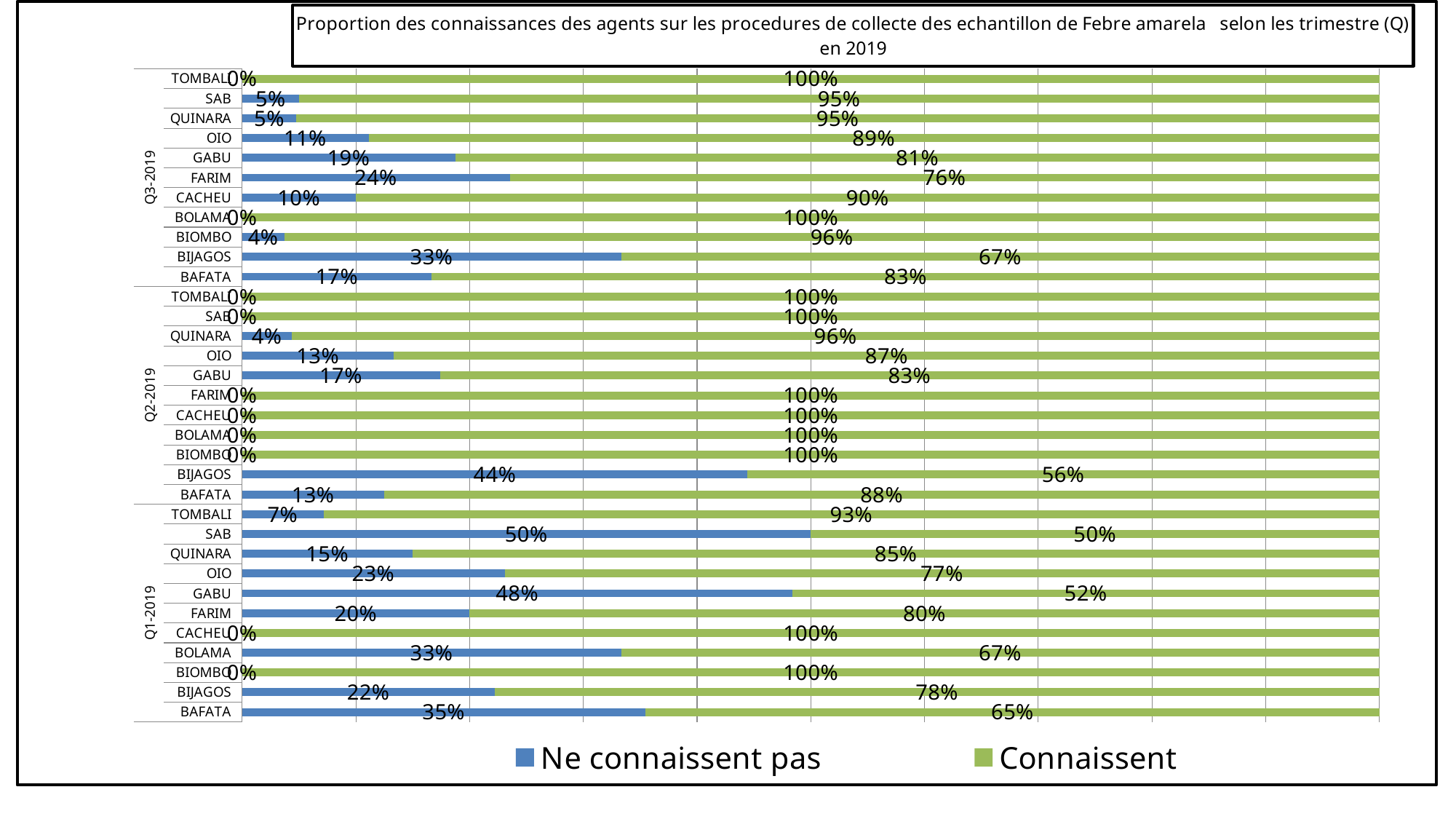
What is the 'Ne connaissent pas' value for BIJAGOS in Q2-2019? 44% What is the 'Ne connaissent pas' value for GABU in Q1-2019? 48% What is the 'Connaissent' value for FARIM in Q3-2019? 76% What is the 'Connaissent' value for BAFATA in Q1-2019? 65% What are the two series named in the legend? Ne connaissent pas; Connaissent Within Q3-2019, which region has the highest 'Ne connaissent pas' value? BIJAGOS Within Q1-2019, which region has the highest 'Ne connaissent pas' value? SAB What type of chart is shown on the slide? bar chart How many series does the legend list? 2 What is the difference between the 'Ne connaissent pas' values for BIJAGOS in Q2-2019 and Q3-2019? 11% Which is larger: the 'Ne connaissent pas' value for OIO in Q1-2019 or for OIO in Q3-2019? OIO in Q1-2019 How many regions are listed within each quarter group on the chart? 11